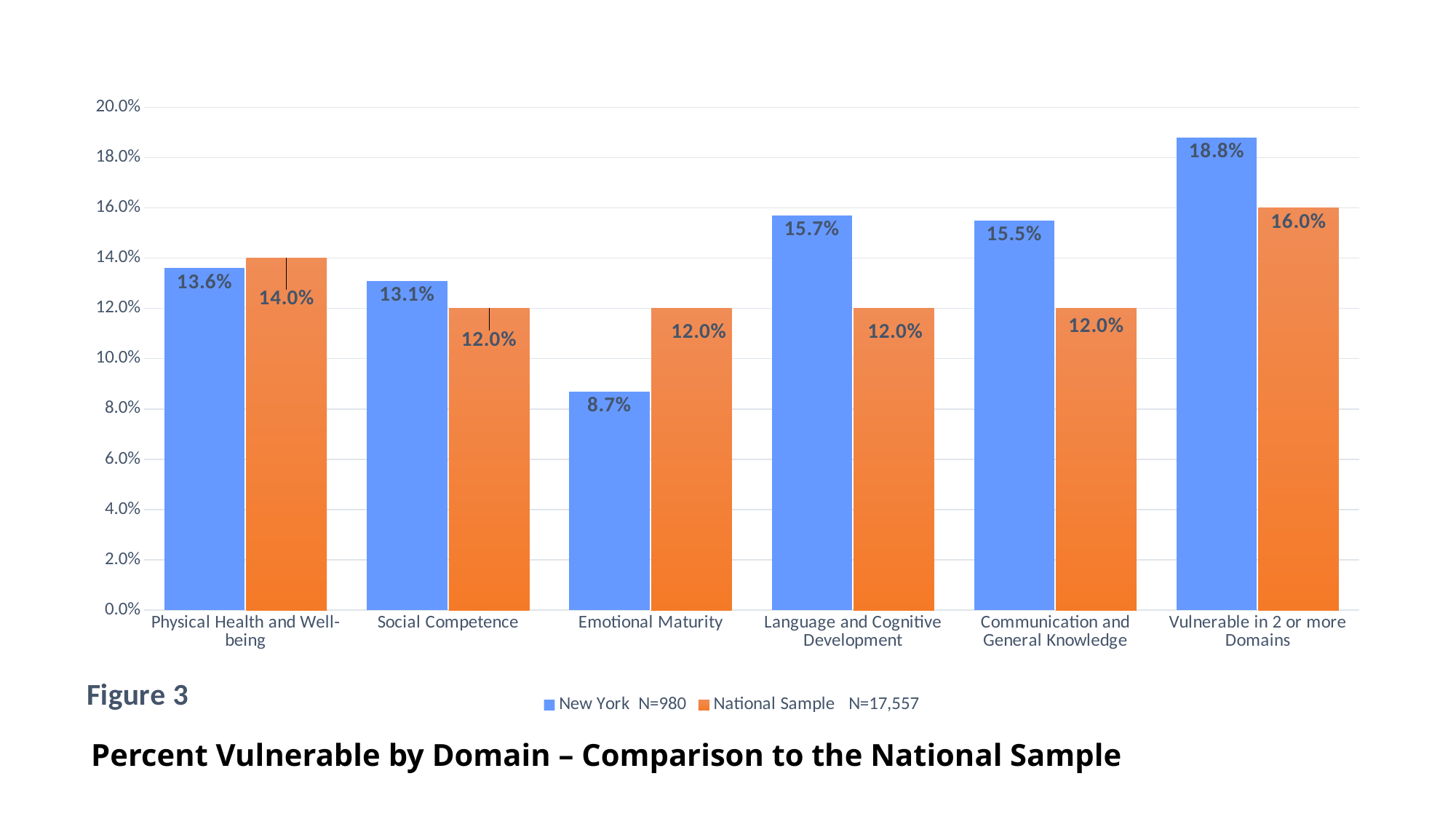
What is the New York value for Emotional Maturity? 8.7% Which domain has the highest New York value? Vulnerable in 2 or more Domains Which domain has the lowest New York value? Emotional Maturity What kind of chart is shown on the slide? Bar chart For Social Competence, which is larger: the New York value or the National Sample value? New York What is the difference between the National Sample and New York values for Emotional Maturity? 3.3% How many series does the legend list? 2 What is the National Sample value for Physical Health and Well-being? 14.0% What is the difference between the New York and National Sample values for Vulnerable in 2 or more Domains? 2.8% What is the New York value for Vulnerable in 2 or more Domains? 18.8% What is the sample size (N) for the National Sample series shown in the legend? N=17,557 How many domains are shown on the x axis? 6